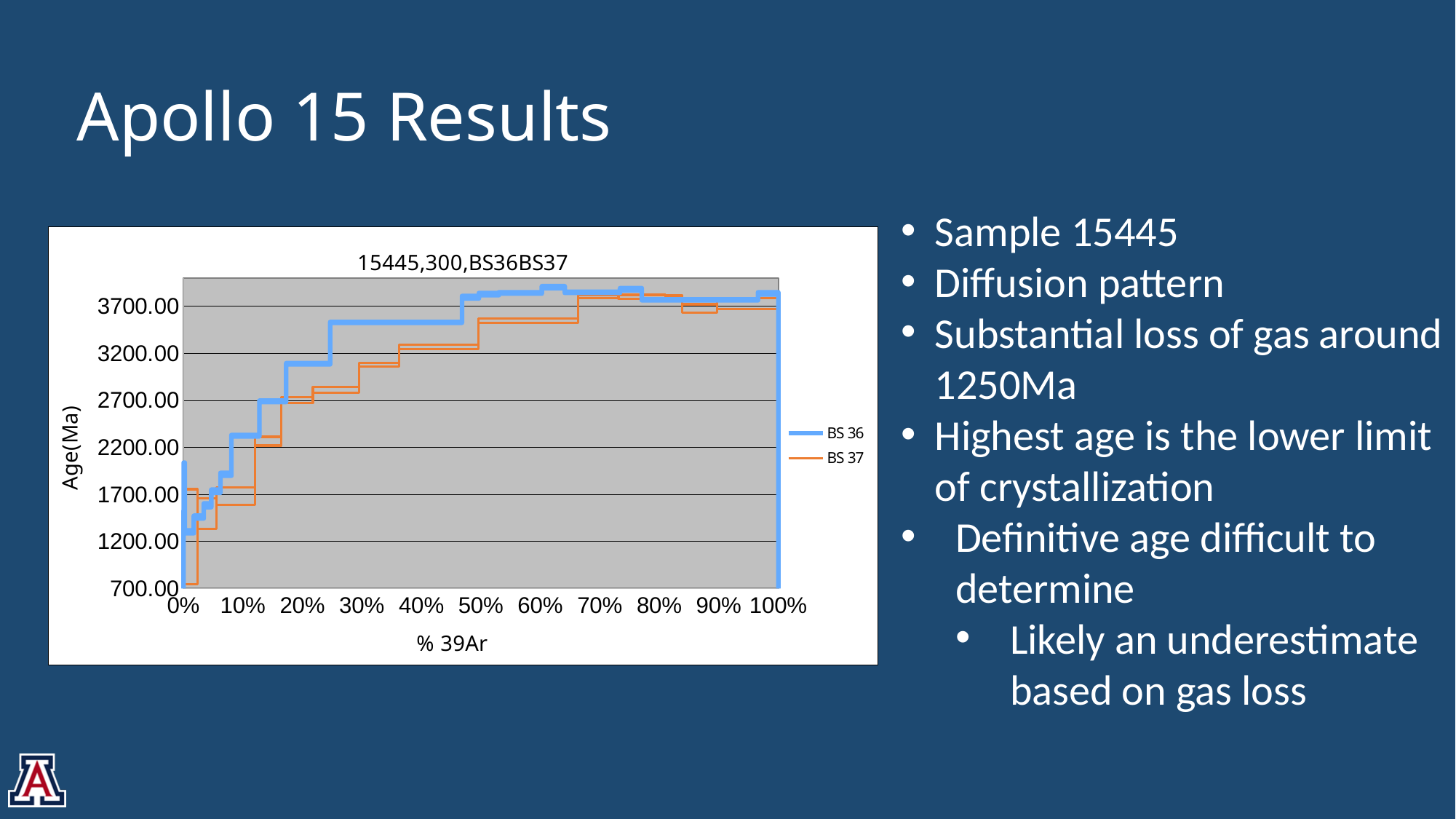
How many series does the chart legend list? 2 What kind of chart is shown on the slide? line chart Is the value for BS 36 at 30% 39Ar greater or less than 3200.00? greater Is the value for BS 36 at 20% 39Ar greater or less than 2700.00? greater At 30% 39Ar, which series has the lower age, BS 36 or BS 37? BS 37 Do the values for BS 36 generally rise or fall as % 39Ar increases from 0% to 100%? rise What are the names of the two series in the chart legend? BS 36 and BS 37 Is the value for BS 37 at 50% 39Ar greater or less than 3700.00? less Do the values for BS 37 generally rise or fall as % 39Ar increases from 0% to 100%? rise What is the title of the chart? 15445,300,BS36BS37 At 40% 39Ar, which series has the higher age, BS 36 or BS 37? BS 36